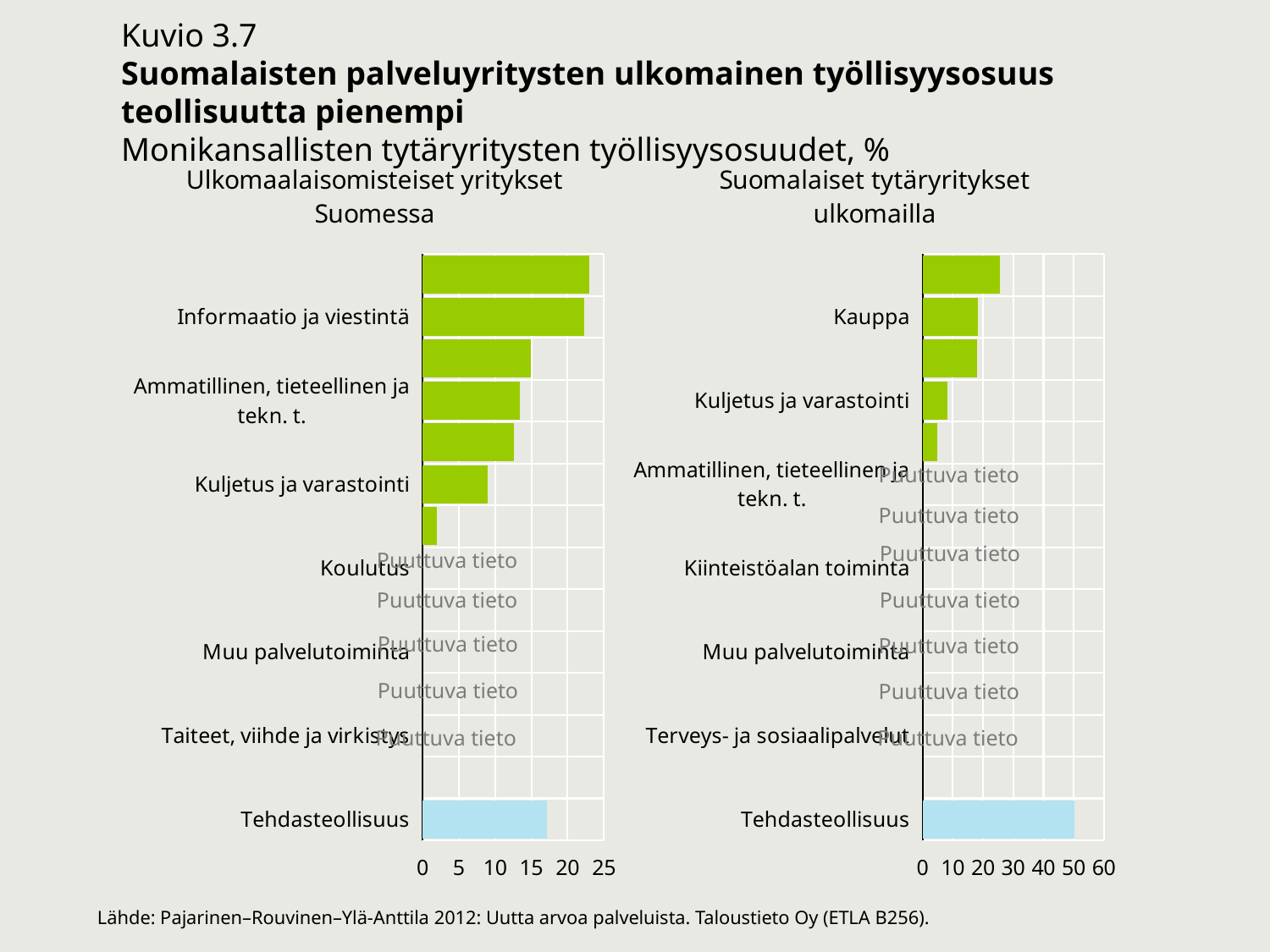
In the left chart (Ulkomaalaisomisteiset yritykset Suomessa), is the value for Ammatillinen, tieteellinen ja tekn. t. greater or less than 10? greater In the left chart (Ulkomaalaisomisteiset yritykset Suomessa), is the value for Tehdasteollisuus greater or less than 10? greater In the right chart (Suomalaiset tytäryritykset ulkomailla), is the value for Kuljetus ja varastointi greater or less than 20? less In the right chart (Suomalaiset tytäryritykset ulkomailla), which is larger: Tehdasteollisuus or Kauppa? Tehdasteollisuus How many charts are shown on the slide? 2 In the left chart (Ulkomaalaisomisteiset yritykset Suomessa), which is larger: Informaatio ja viestintä or Kuljetus ja varastointi? Informaatio ja viestintä What text is shown in place of bars where data is missing in the charts? Puuttuva tieto What kind of chart is used on this slide? bar chart